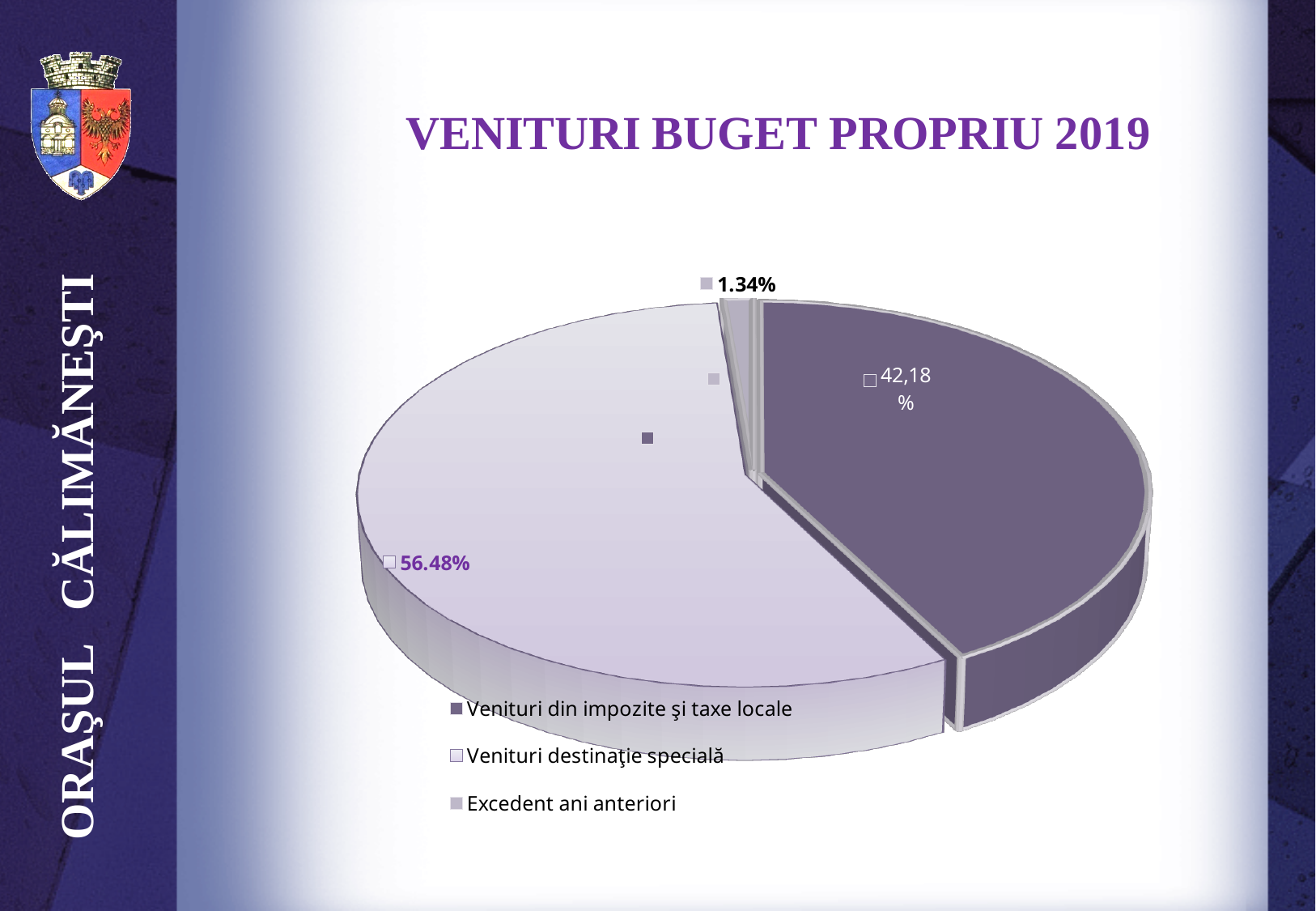
Which legend entry is listed first? Venituri din impozite şi taxe locale What is the difference in percentage points between the share for Venituri destinaţie specială and the share for Venituri din impozite şi taxe locale? 14.30 Which category has the smallest share of the pie? Excedent ani anteriori How many entries does the legend list? 3 Which category has the largest share of the pie? Venituri destinaţie specială Which is larger: the share for Venituri destinaţie specială or the share for Venituri din impozite şi taxe locale? Venituri destinaţie specială What share of the pie is Excedent ani anteriori? 1.34% How many slices does the pie chart have? 3 What share of the pie is Venituri destinaţie specială? 56.48% What share of the pie is Venituri din impozite şi taxe locale? 42,18% What is the chart's title? VENITURI BUGET PROPRIU 2019 What kind of chart is shown on the slide? pie chart